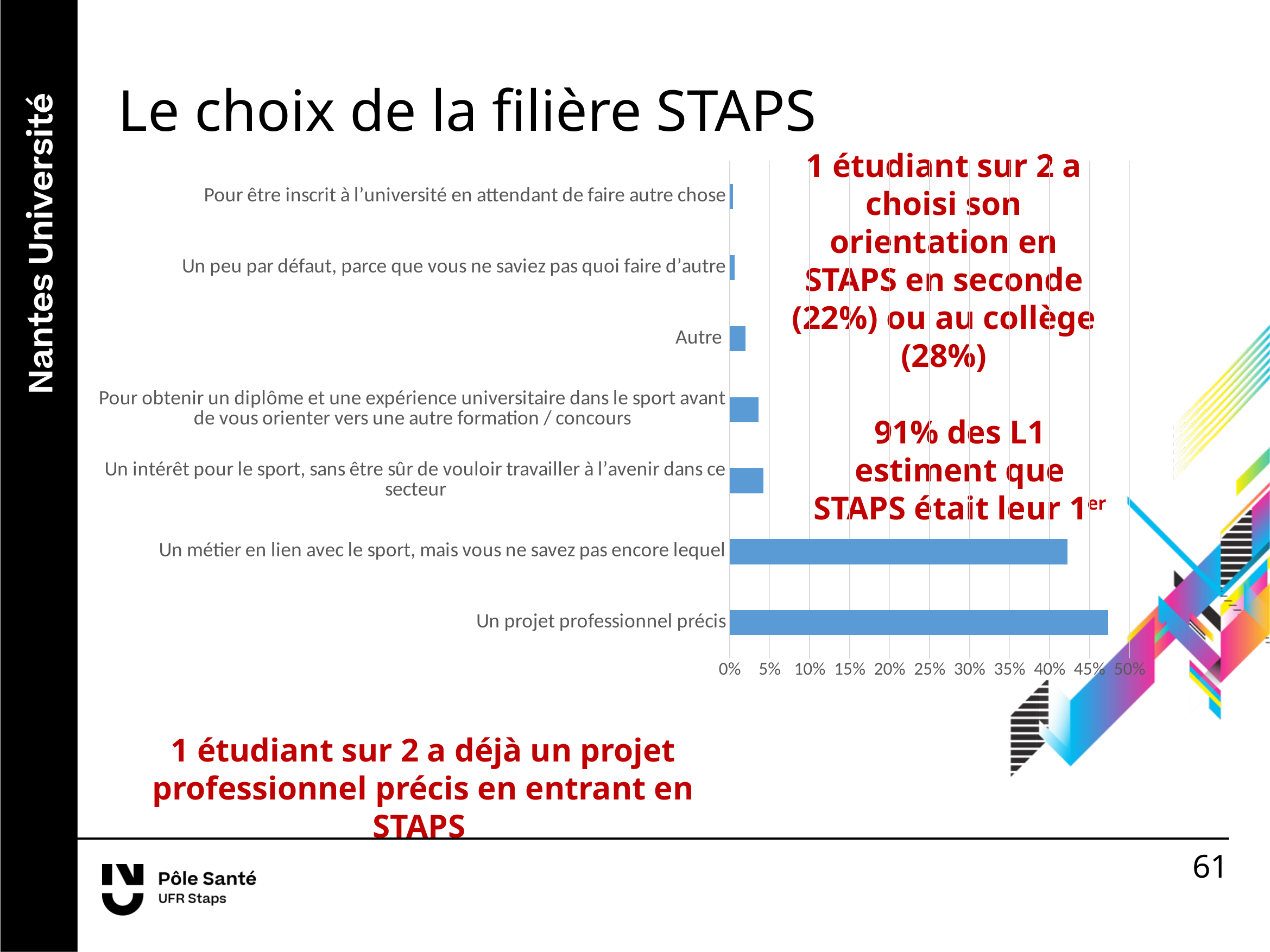
Is the value for "Un métier en lien avec le sport, mais vous ne savez pas encore lequel" greater or less than 40%? greater Which category has the highest value in the bar chart? Un projet professionnel précis Which is larger: the value for "Un projet professionnel précis" or the value for "Un métier en lien avec le sport, mais vous ne savez pas encore lequel"? Un projet professionnel précis Is the value for "Un projet professionnel précis" greater or less than 45%? greater How many categories does the bar chart show? 7 Is the value for "Un intérêt pour le sport, sans être sûr de vouloir travailler à l'avenir dans ce secteur" greater or less than 10%? less What kind of chart is shown on the slide? bar chart What is the highest value shown on the chart's percentage axis? 50% What colour are the bars in the chart? blue Which is larger: the value for "Autre" or the value for "Un métier en lien avec le sport, mais vous ne savez pas encore lequel"? Un métier en lien avec le sport, mais vous ne savez pas encore lequel